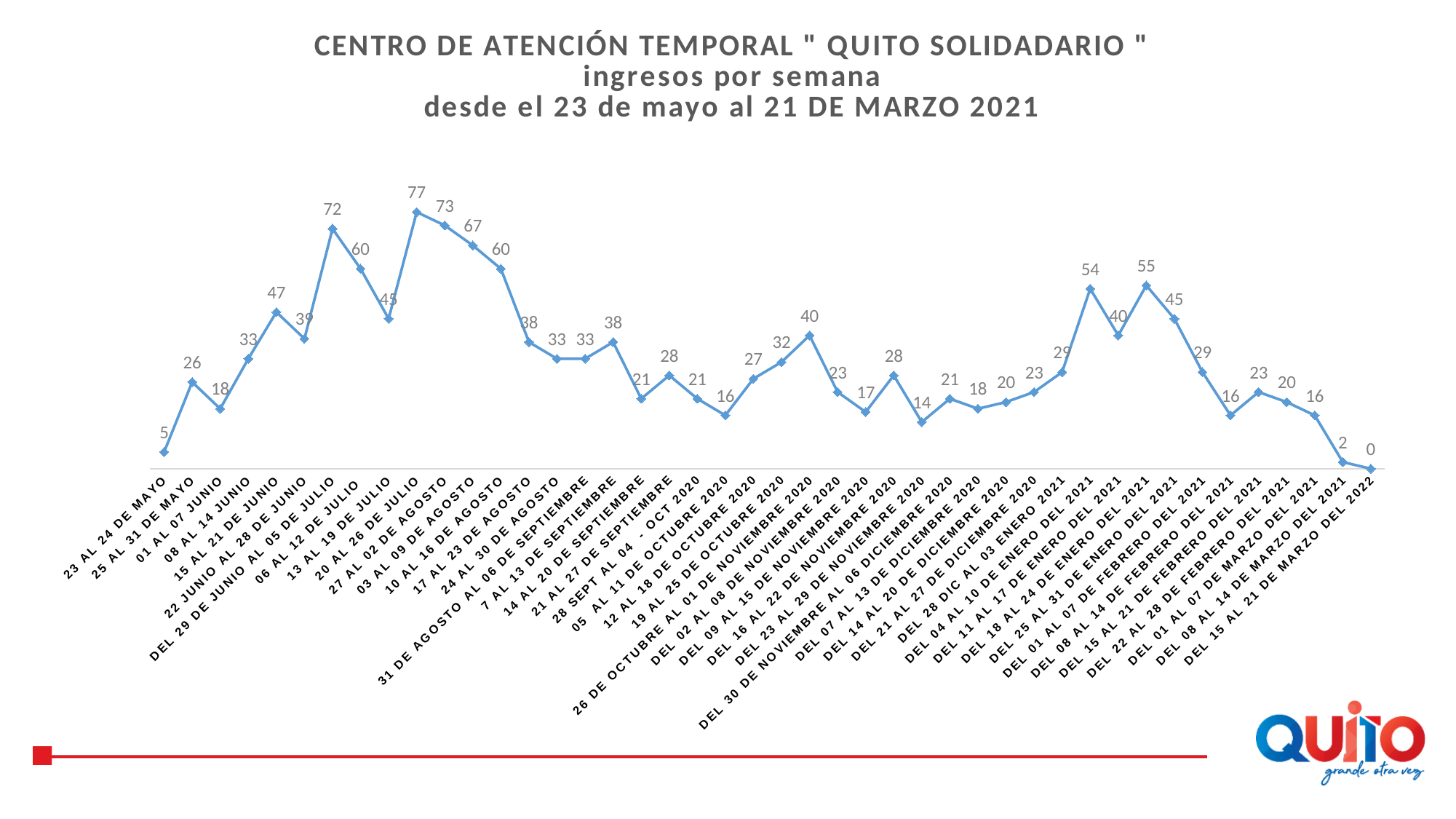
What is the value for the week DEL 08 AL 14 DE MARZO DEL 2021? 2 What is the difference between the values for DEL 18 AL 24 DE ENERO DEL 2021 and DEL 25 AL 31 DE ENERO DEL 2021? 10 Which week has a larger value, DEL 29 DE JUNIO AL 05 DE JULIO or 06 AL 12 DE JULIO? DEL 29 DE JUNIO AL 05 DE JULIO Which week has the lowest number of admissions? DEL 15 AL 21 DE MARZO DEL 2022 What is the difference between the values for 20 AL 26 DE JULIO and 27 AL 02 DE AGOSTO? 4 How many weekly admissions were recorded for the week 20 AL 26 DE JULIO? 77 What is the value for the week 23 AL 24 DE MAYO? 5 What type of chart is shown on the slide? line chart What is the value for the week DEL 04 AL 10 DE ENERO DEL 2021? 54 What is the title of the chart? CENTRO DE ATENCIÓN TEMPORAL " QUITO SOLIDADARIO " ingresos por semana desde el 23 de mayo al 21 DE MARZO 2021 Do the values rise or fall from DEL 01 AL 07 DE MARZO DEL 2021 to DEL 15 AL 21 DE MARZO DEL 2022? fall Which week has the highest number of admissions? 20 AL 26 DE JULIO